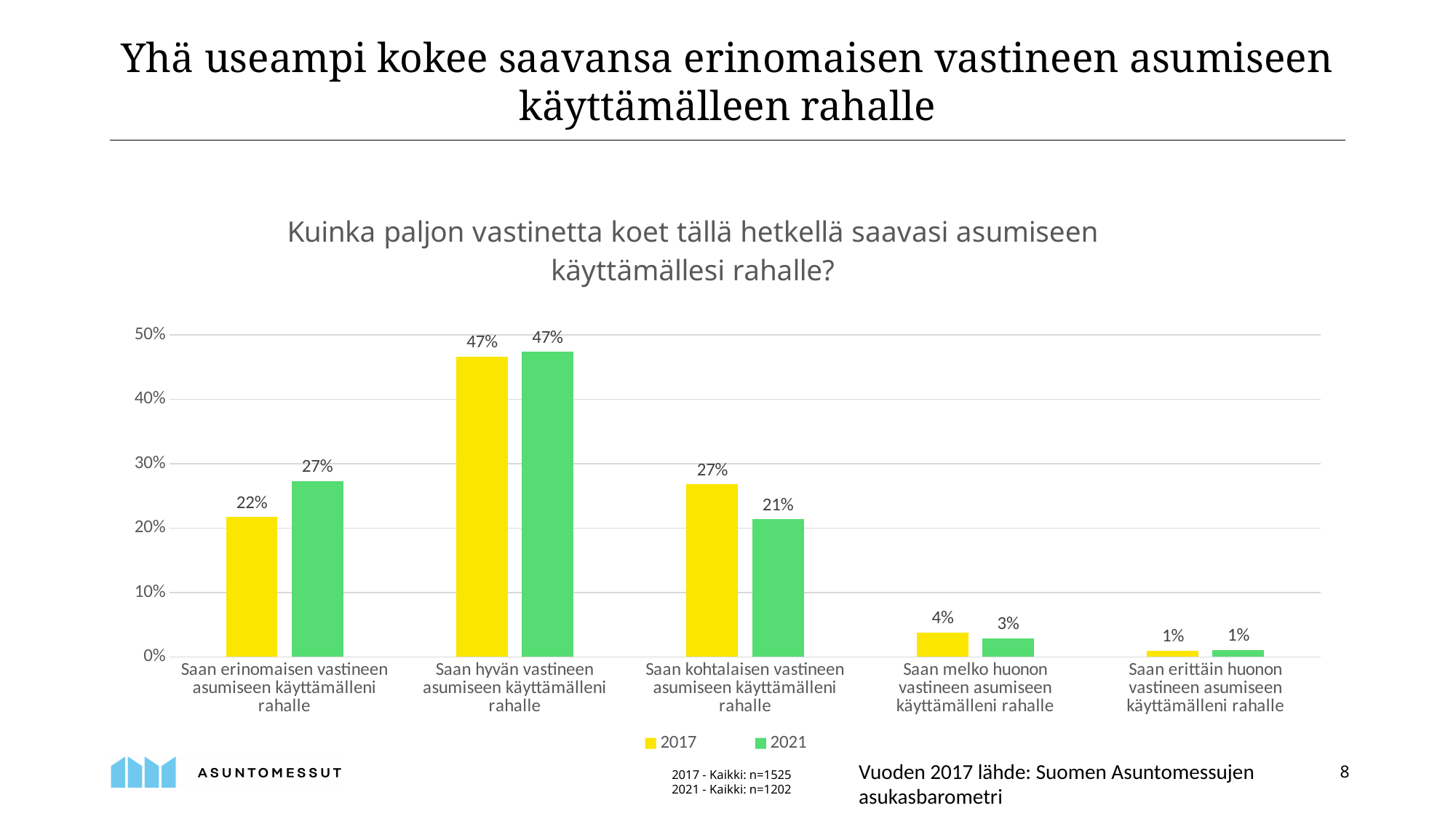
Is the 2017 value for "Saan hyvän vastineen asumiseen käyttämälleni rahalle" greater or less than 40%? greater What kind of chart is shown on the slide? bar chart For "Saan kohtalaisen vastineen asumiseen käyttämälleni rahalle", which series has the larger value, 2017 or 2021? 2017 Which colour represents the 2021 series in the chart? green How many categories are shown on the x axis? 5 Which category has the lowest value for the 2017 series? Saan erittäin huonon vastineen asumiseen käyttämälleni rahalle What is the difference between the 2021 and 2017 values for "Saan erinomaisen vastineen asumiseen käyttämälleni rahalle"? 5% Which category has the highest value for the 2021 series? Saan hyvän vastineen asumiseen käyttämälleni rahalle What is the 2021 value for "Saan erinomaisen vastineen asumiseen käyttämälleni rahalle"? 27% How many series does the legend list? 2 What is the 2017 value for "Saan kohtalaisen vastineen asumiseen käyttämälleni rahalle"? 27% What is the 2017 value for "Saan melko huonon vastineen asumiseen käyttämälleni rahalle"? 4%